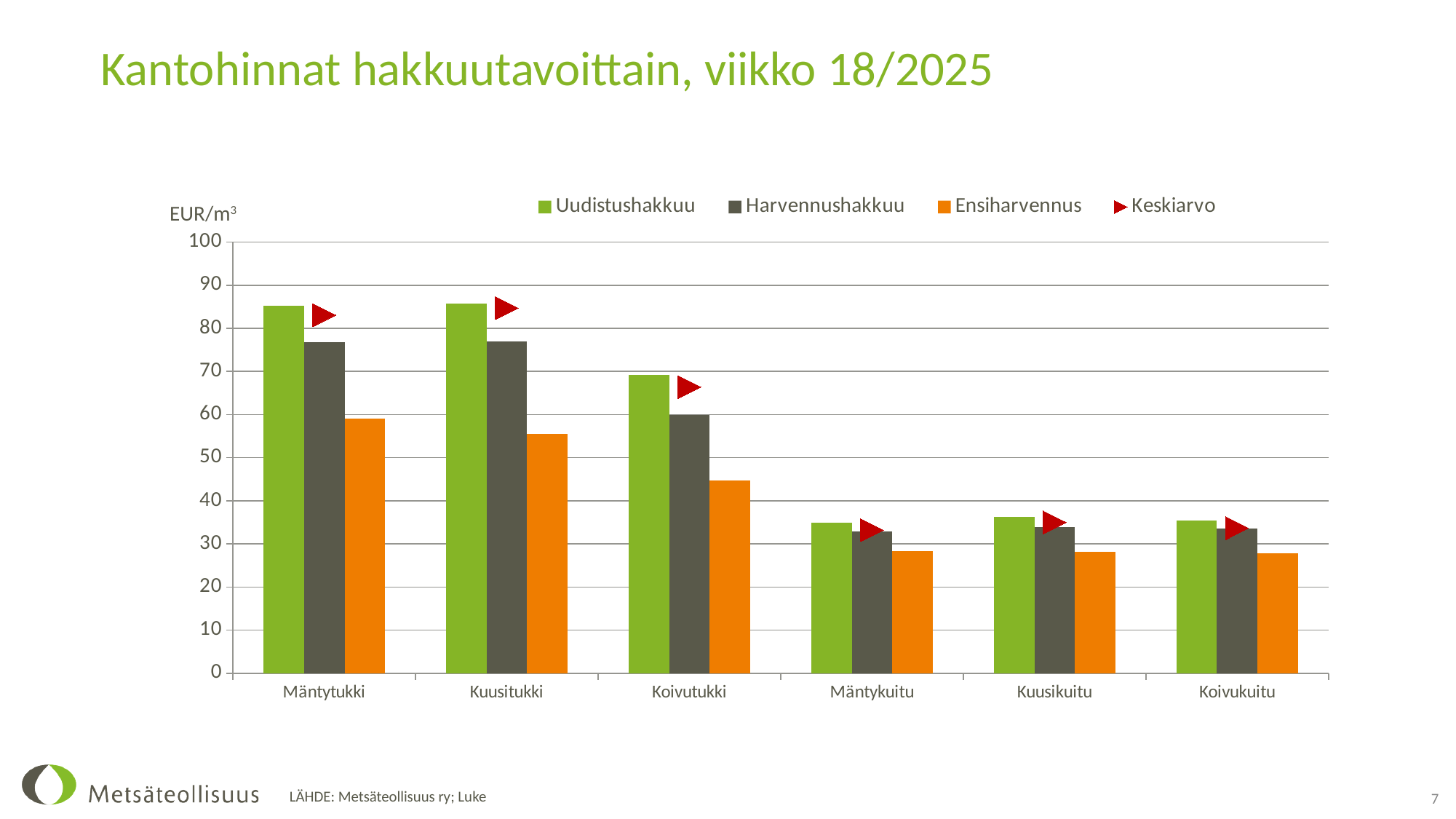
What unit is shown on the vertical axis? EUR/m³ Which category has the highest Ensiharvennus value? Mäntytukki For Koivutukki, which is larger: the Uudistushakkuu value or the Harvennushakkuu value? Uudistushakkuu Is the Harvennushakkuu value for Kuusitukki greater or less than 80? less Is the Ensiharvennus value for Mäntykuitu greater or less than 30? less Is the Ensiharvennus value for Koivutukki greater or less than 50? less How many series does the legend list? 4 What kind of chart is shown on the slide? bar chart How many categories are shown on the x axis? 6 Which is larger: the Ensiharvennus value for Mäntytukki or for Koivutukki? Mäntytukki